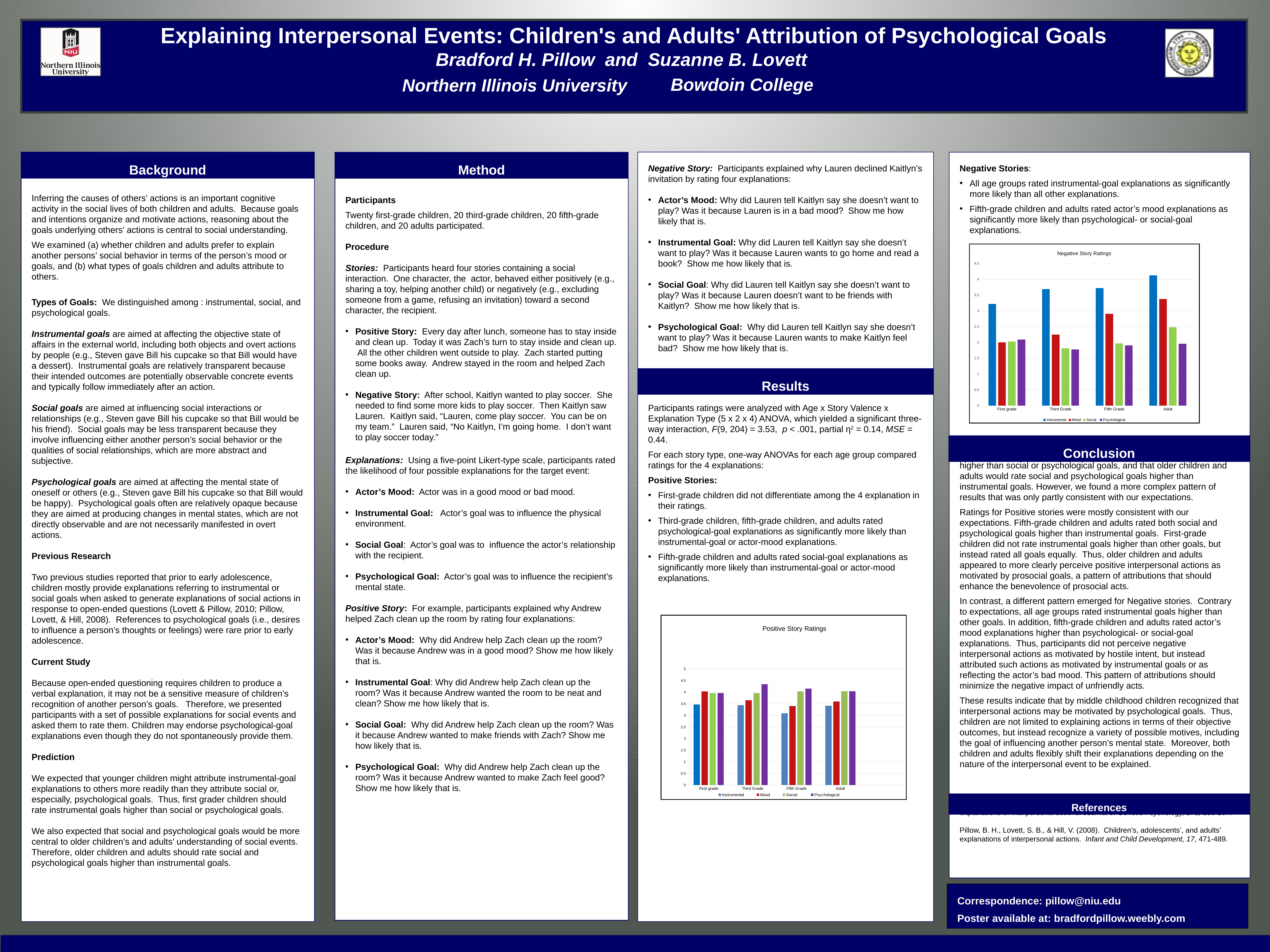
In the "Negative Story Ratings" chart, which series has the highest bar for the Adult group? Instrumental How many series does the legend of the "Negative Story Ratings" chart list? 4 What is the title of the chart in the Results section? Positive Story Ratings What kind of chart is the "Negative Story Ratings" chart? bar chart In the "Negative Story Ratings" chart, is the Social value for Third Grade greater or less than 2? less In the "Positive Story Ratings" chart, is the Instrumental value for Fifth Grade greater or less than 3.5? less In the "Negative Story Ratings" chart, is the Instrumental value for Adult greater or less than 4? greater How many age-group categories are shown on the x axis of the "Positive Story Ratings" chart? 4 In the "Positive Story Ratings" chart, which series has the lowest bar for Fifth Grade? Instrumental In the "Positive Story Ratings" chart, which series has the highest bar for Third Grade? Psychological In the "Negative Story Ratings" chart, which is larger for Fifth Grade: Mood or Psychological? Mood In the "Negative Story Ratings" chart, does the Instrumental series rise or fall from First grade to Adult? rise